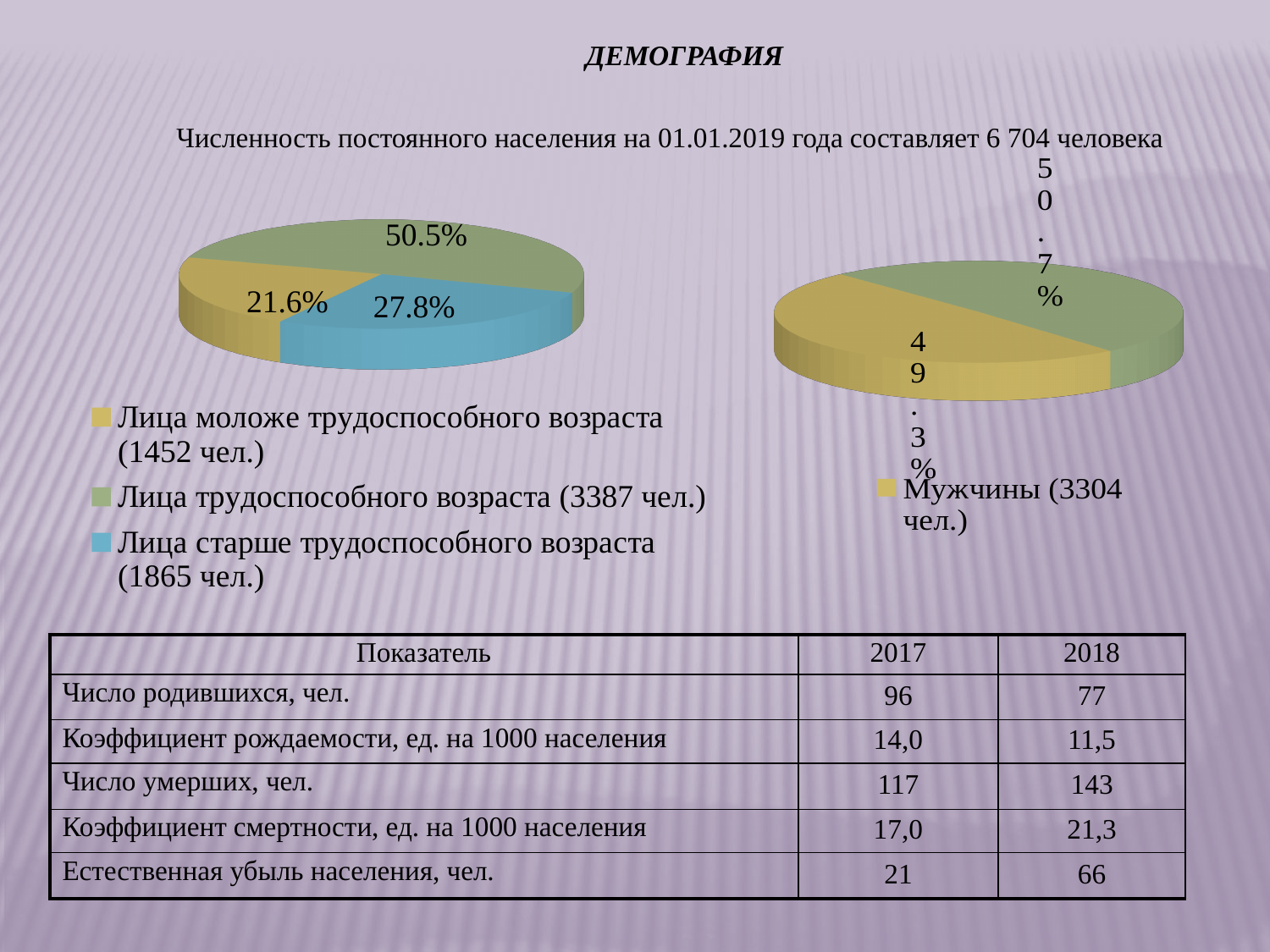
On the left pie chart, which slice is larger: Лица старше трудоспособного возраста or Лица моложе трудоспособного возраста? Лица старше трудоспособного возраста On the left pie chart, which category has the largest slice? Лица трудоспособного возраста On the left pie chart, what is the difference in percentage points between the slices for Лица трудоспособного возраста and Лица моложе трудоспособного возраста? 28.9 What type of chart is the left chart on the slide? Pie chart How many slices does the left pie chart have? 3 On the left pie chart, what share is shown for Лица старше трудоспособного возраста? 27.8% On the left pie chart, which category has the smallest slice? Лица моложе трудоспособного возраста On the right pie chart, what share is shown for Мужчины? 49.3% How many slices does the right pie chart have? 2 On the left pie chart, what share is shown for Лица трудоспособного возраста? 50.5% On the left pie chart, what share is shown for Лица моложе трудоспособного возраста? 21.6% How many entries does the legend of the left pie chart list? 3